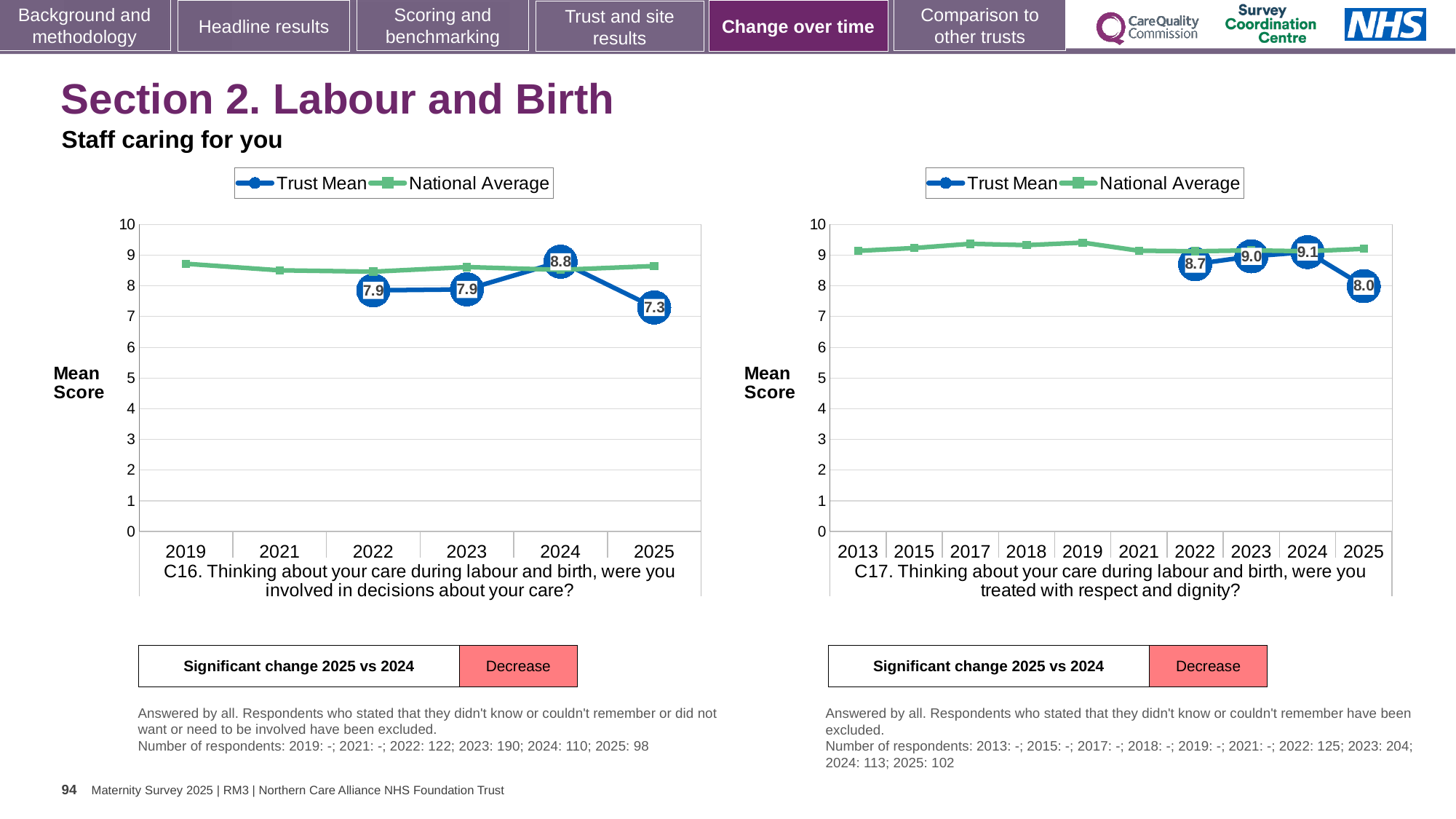
In the C17 chart on the right, is the Trust Mean score for 2023 or 2025 larger? 2023 How many years are shown on the x axis of the C17 chart on the right? 10 In the C17 chart on the right, what is the Trust Mean score for 2022? 8.7 In the C17 chart on the right, what is the Trust Mean score for 2025? 8.0 In the C16 chart on the left, what is the Trust Mean score for 2025? 7.3 How many series does the legend of the C16 chart on the left list? 2 In the C17 chart on the right, what is the difference between the Trust Mean scores for 2024 and 2025? 1.1 In the C16 chart on the left, is the National Average value for 2019 greater or less than 8? greater In the C16 chart on the left, what is the difference between the Trust Mean scores for 2024 and 2025? 1.5 In the C16 chart on the left, which year has the highest labelled Trust Mean score? 2024 In the C16 chart on the left, what is the Trust Mean score for 2024? 8.8 In the C17 chart on the right, which year has the lowest labelled Trust Mean score? 2025